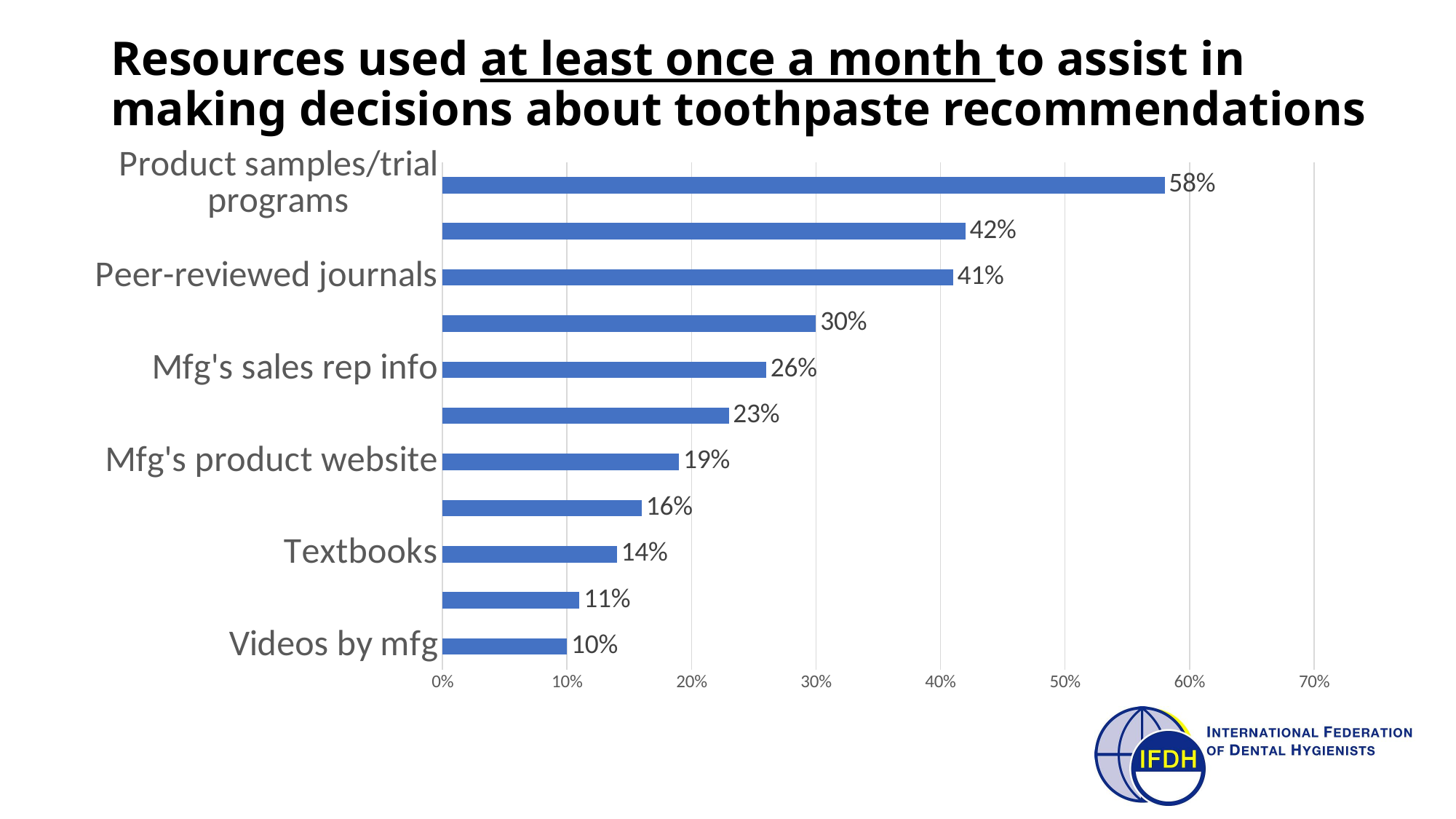
What percentage is shown for Videos by mfg? 10% What percentage is shown for Product samples/trial programs? 58% What is the difference between the percentages for Product samples/trial programs and Peer-reviewed journals? 17% What percentage is shown for Mfg's sales rep info? 26% What is the highest value shown on the horizontal axis? 70% How many bars are plotted in the chart? 11 Which is larger, the value for Mfg's product website or the value for Textbooks? Mfg's product website Which labeled resource has the lowest percentage? Videos by mfg What kind of chart is shown on the slide? Bar chart Which labeled resource has the highest percentage? Product samples/trial programs What percentage is shown for Peer-reviewed journals? 41% What percentage is shown for Textbooks? 14%